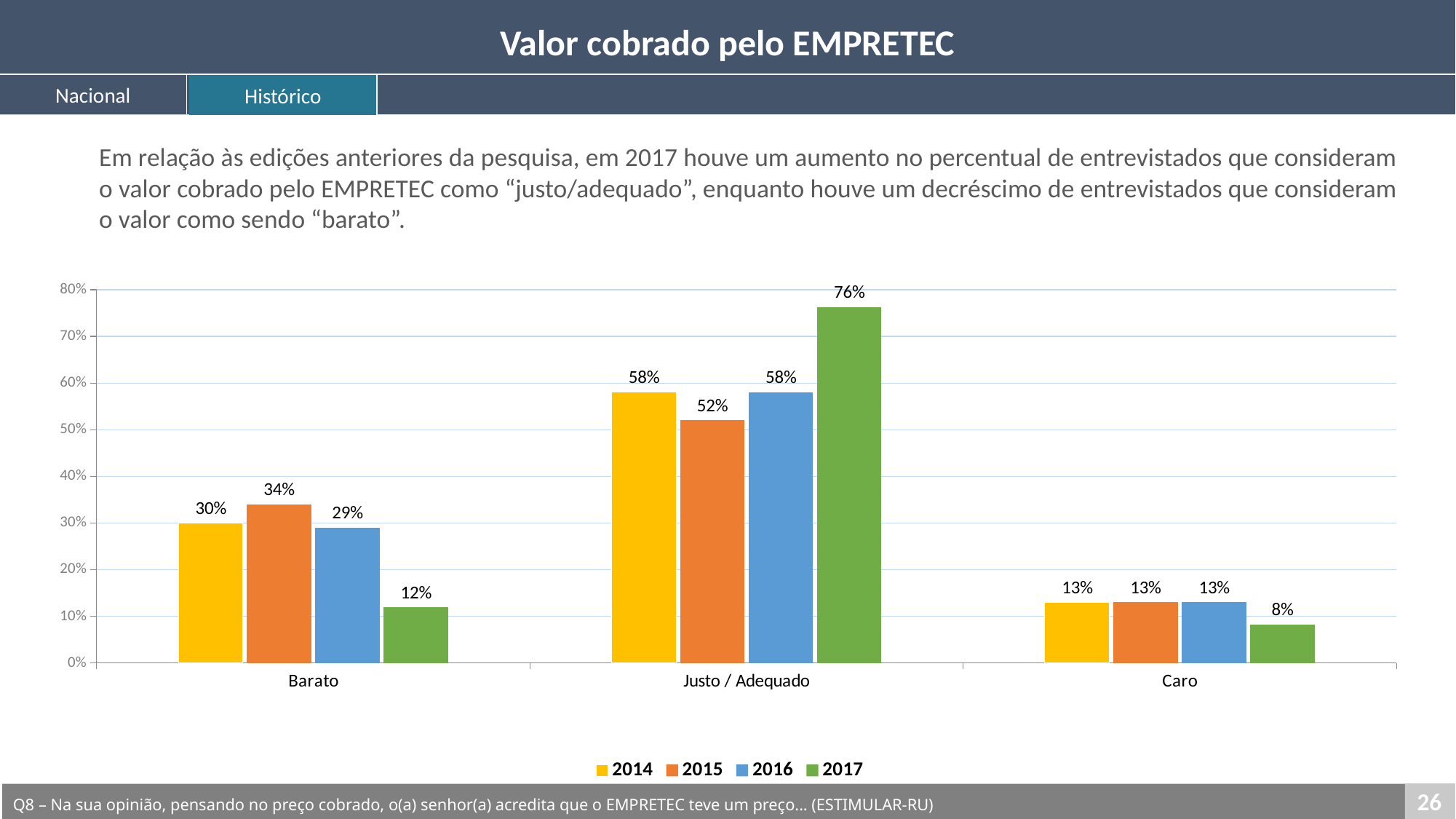
Which category has the highest value for the 2016 series? Justo / Adequado What kind of chart is shown on the slide? Bar chart Which year has the lowest value in the Barato category? 2017 What is the value for 2015 in the Barato category? 34% What is the value for 2017 in the Caro category? 8% How many series does the legend list? 4 How many categories are shown on the x axis? 3 What is the value for 2017 in the Justo / Adequado category? 76% What is the difference between the 2015 and 2017 values in the Barato category? 22% Which colour represents the 2017 series in the legend? Green What is the difference between the 2017 and 2016 values in the Justo / Adequado category? 18% Which is larger in the Justo / Adequado category: the 2014 value or the 2015 value? 2014